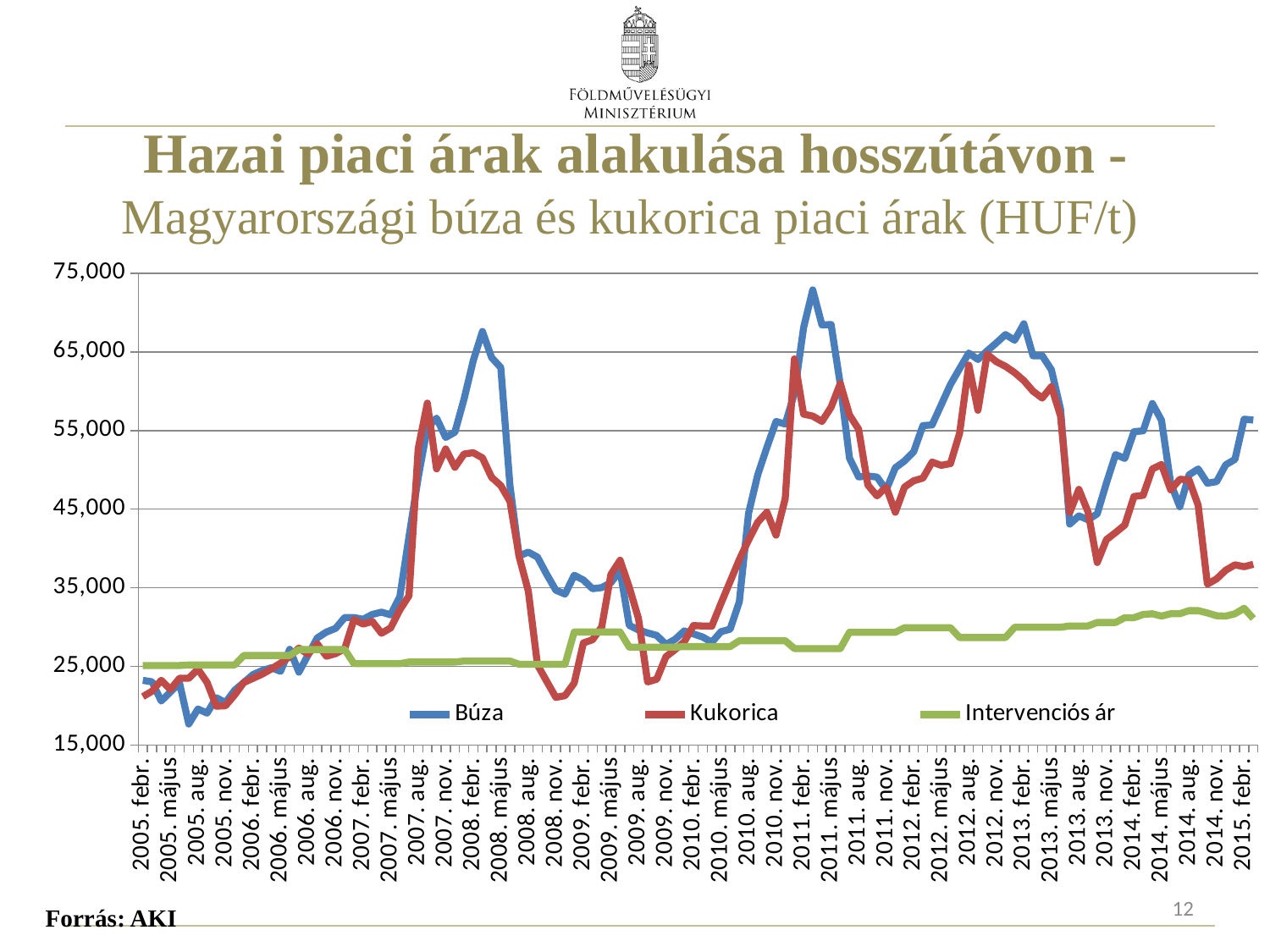
In what unit are the prices on the chart given, according to the title? HUF/t Is the value for Búza at 2005. aug. greater or less than 25,000? less What are the three series named in the legend? Búza, Kukorica, Intervenciós ár At 2011. febr., which is higher, Búza or Kukorica? Búza Is the value for Intervenciós ár at 2015. febr. greater or less than 35,000? less Is the value for Búza at 2011. febr. greater or less than 65,000? greater What kind of chart is shown on the slide? line chart How many series does the legend list? 3 Which series reaches the highest value anywhere on the chart? Búza At 2009. aug., which is higher, Búza or Kukorica? Kukorica Does the Intervenciós ár series generally rise or fall from 2005. febr. to 2015. febr.? rise